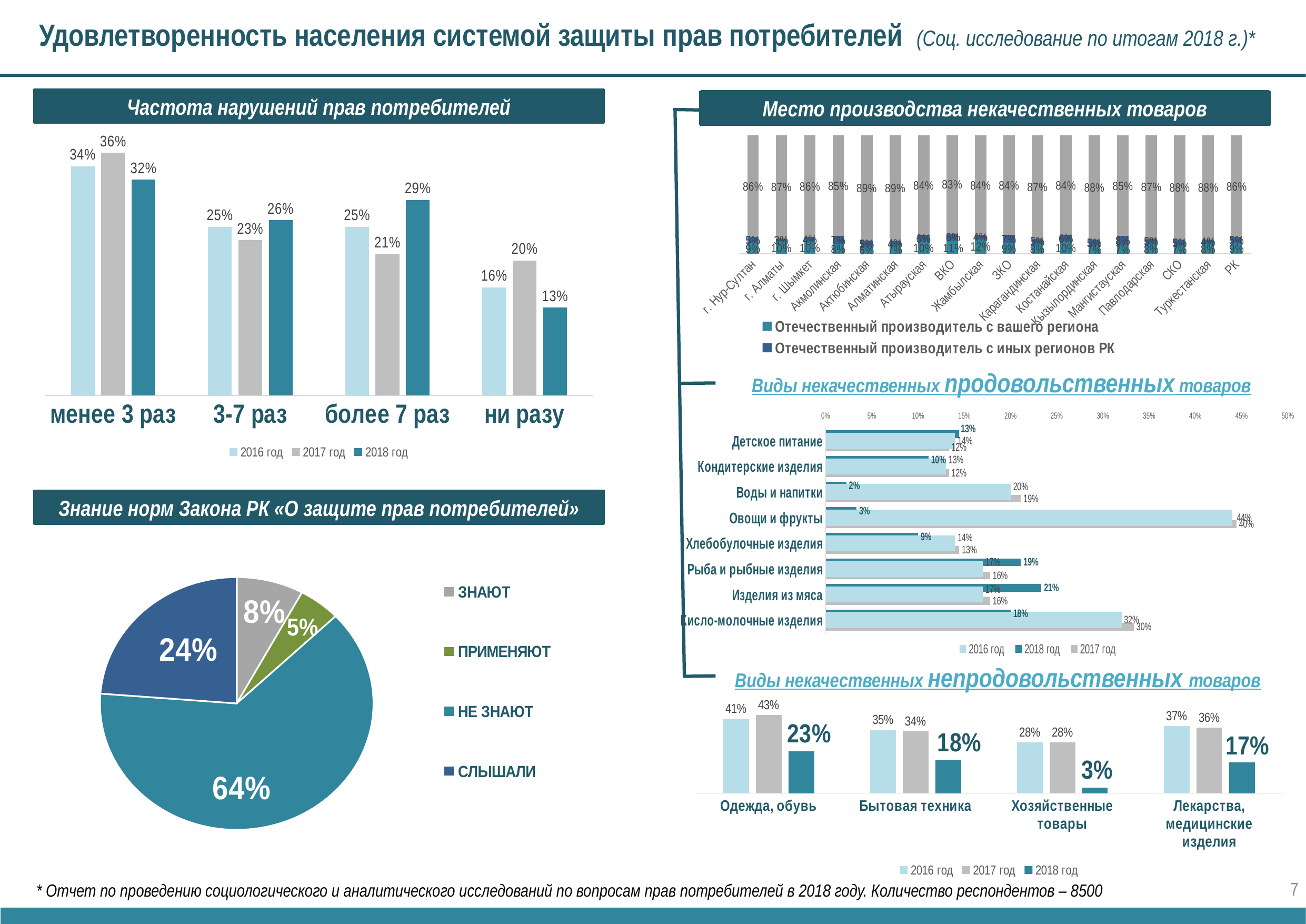
In the chart 'Место производства некачественных товаров', how many regions are shown on the x axis? 18 What kind of chart is 'Знание норм Закона РК «О защите прав потребителей»'? pie chart In the pie chart 'Знание норм Закона РК «О защите прав потребителей»', which category has the smallest slice? ПРИМЕНЯЮТ In the chart 'Виды некачественных непродовольственных товаров', what is the difference between the 2017 год and 2018 год values for 'Одежда, обувь'? 20% In the chart 'Виды некачественных продовольственных товаров', what is the value for 'Овощи и фрукты' in 2016 год? 44% In the chart 'Виды некачественных продовольственных товаров', which is larger for 'Изделия из мяса': 2018 год or 2017 год? 2018 год In the chart 'Виды некачественных непродовольственных товаров', what is the value for 'Хозяйственные товары' in 2018 год? 3% In the pie chart 'Знание норм Закона РК «О защите прав потребителей»', what share is 'НЕ ЗНАЮТ'? 64% In the chart 'Частота нарушений прав потребителей', what is the value for 'ни разу' in 2017 год? 20% How many series does the legend of the chart 'Частота нарушений прав потребителей' list? 3 In the chart 'Частота нарушений прав потребителей', what is the difference between the 2018 год and 2017 год values for 'более 7 раз'? 8% In the chart 'Частота нарушений прав потребителей', which category has the highest value for 2018 год? менее 3 раз